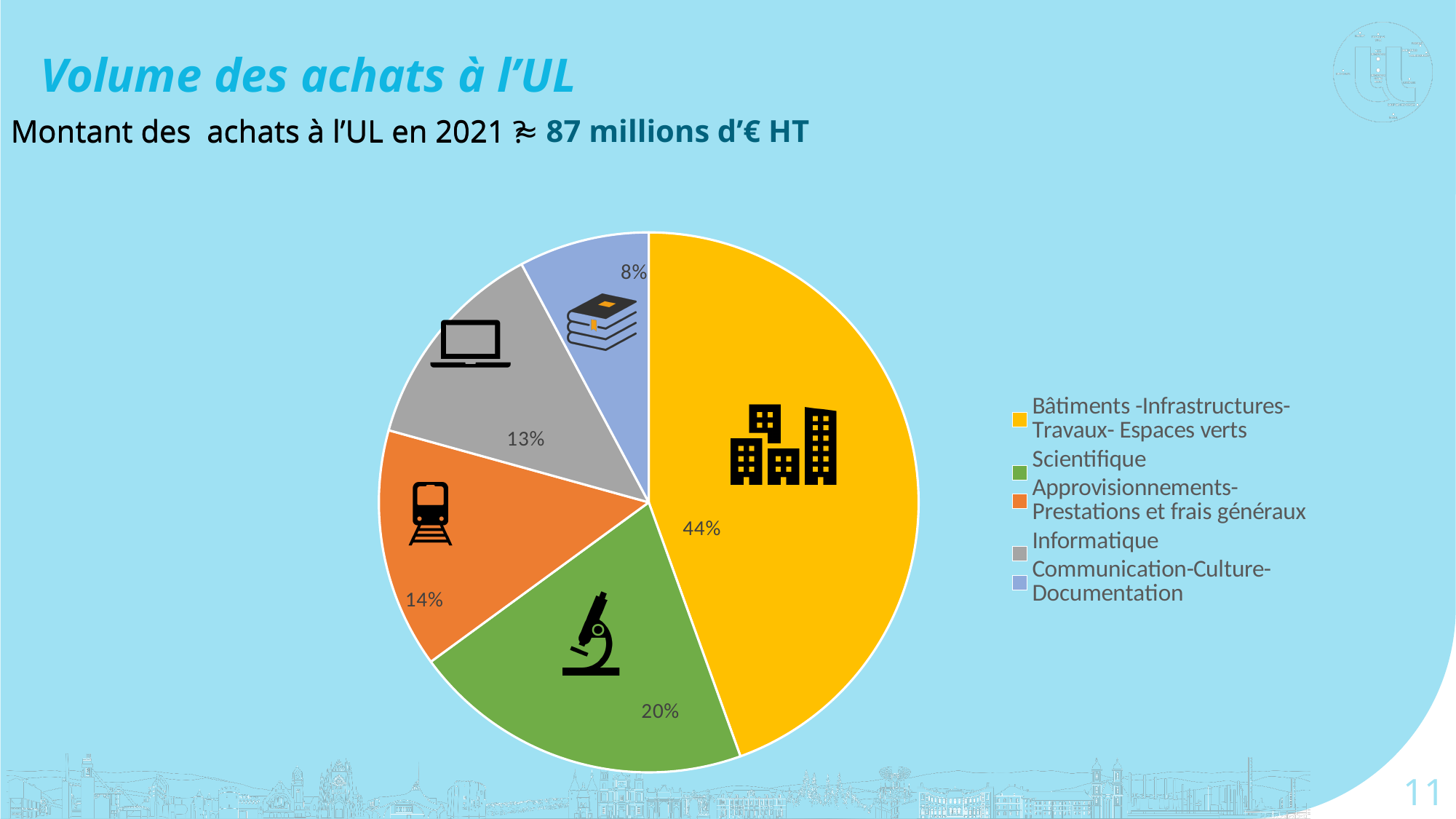
What share of the pie does the Scientifique slice represent? 20% What is the value shown for Communication-Culture-Documentation? 8% What kind of chart is shown on the slide? pie chart Which category has the smallest share of the pie? Communication-Culture-Documentation Which is larger, the share for Scientifique or the share for Informatique? Scientifique What colour is the Scientifique slice? green What is the difference between the shares of Approvisionnements-Prestations et frais généraux and Communication-Culture-Documentation? 6% What is the value shown for Approvisionnements-Prestations et frais généraux? 14% What is the value shown for Informatique? 13% Which category has the largest share of the pie? Bâtiments -Infrastructures-Travaux- Espaces verts What is the difference between the shares of Bâtiments -Infrastructures-Travaux- Espaces verts and Scientifique? 24% How many categories does the pie chart have? 5